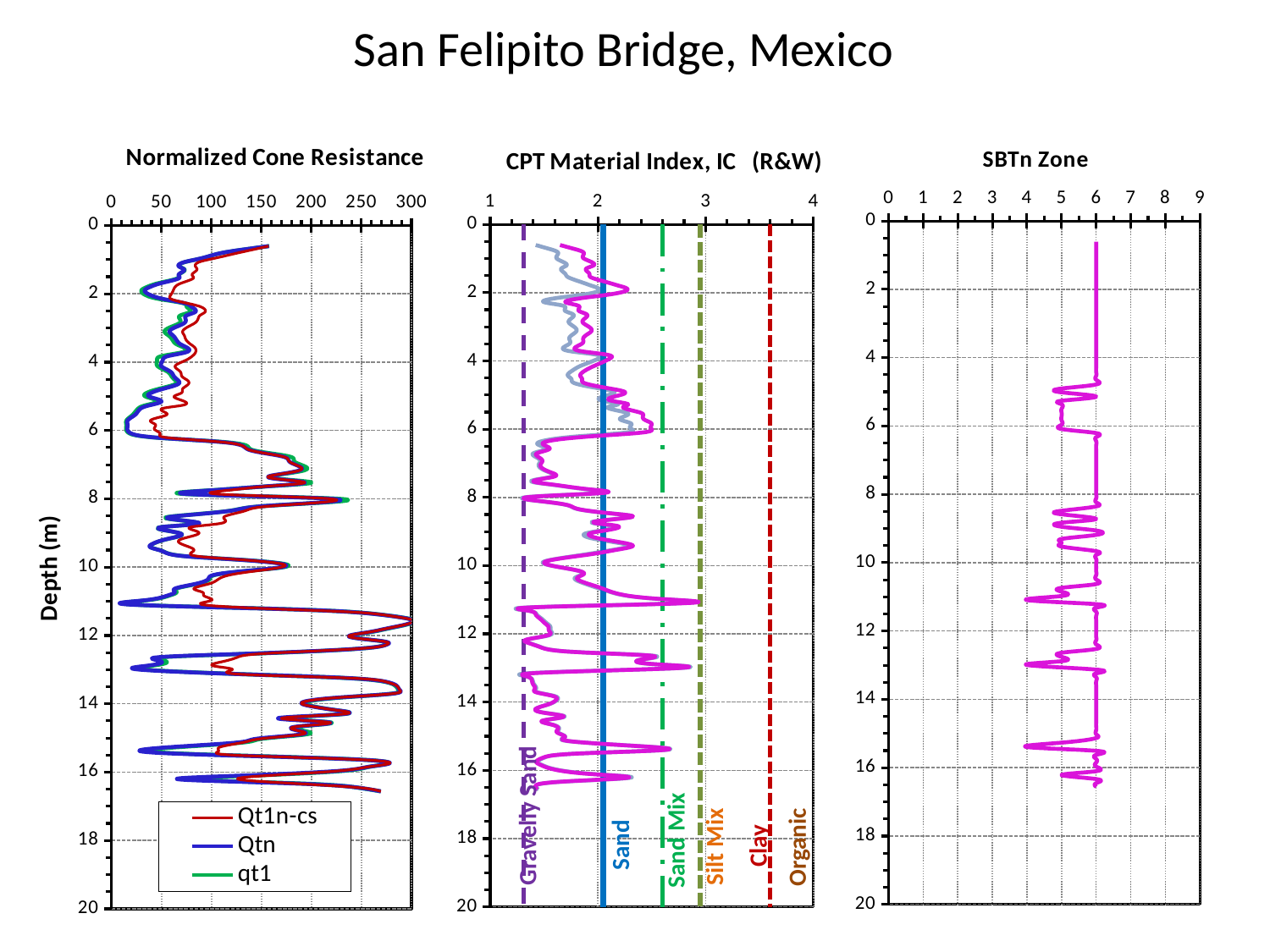
In the Normalized Cone Resistance chart, is the Qtn value at a depth of 6 m greater or less than 50? less How many series does the legend of the Normalized Cone Resistance chart list? 3 In the CPT Material Index chart, is the IC value at a depth of 14 m greater or less than 2? less What kind of chart is the Normalized Cone Resistance chart? line chart In the Normalized Cone Resistance chart, does the Qtn value generally rise or fall as depth increases from 0 m to 6 m? fall In the Normalized Cone Resistance chart, is the Qt1n-cs value at a depth of about 11.5 m greater or less than 250? greater In the SBTn Zone chart, what is the zone value at a depth of 2 m? 6 In the CPT Material Index chart, which soil type label is attached to the dashed vertical line at about IC = 3.6? Clay What are the three series named in the legend of the Normalized Cone Resistance chart? Qt1n-cs, Qtn, qt1